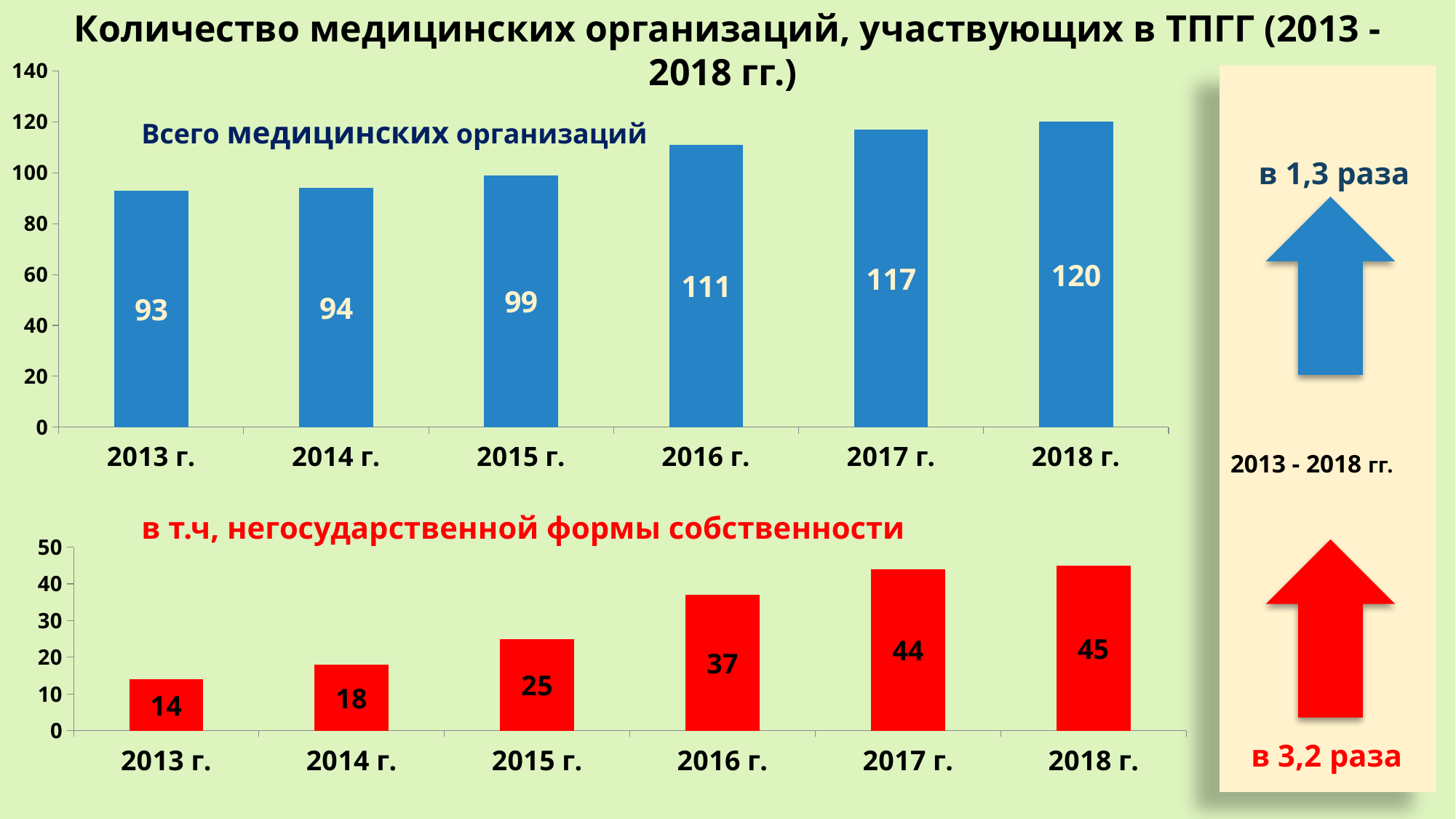
How many years are shown in the top chart (Всего медицинских организаций)? 6 In the bottom chart (в т.ч, негосударственной формы собственности), is the value for 2017 г. greater or less than 40? greater What kind of chart is the bottom chart (в т.ч, негосударственной формы собственности)? bar chart In the bottom chart (в т.ч, негосударственной формы собственности), which year has the lowest value? 2013 г. In the bottom chart (в т.ч, негосударственной формы собственности), do the values rise or fall from 2013 г. to 2018 г.? rise In the bottom chart (в т.ч, негосударственной формы собственности), what is the difference between the values for 2016 г. and 2014 г.? 19 In the top chart (Всего медицинских организаций), which year has the highest value? 2018 г. In the top chart (Всего медицинских организаций), which is larger: the value for 2015 г. or the value for 2017 г.? 2017 г. In the top chart (Всего медицинских организаций), what is the difference between the values for 2018 г. and 2013 г.? 27 What colour are the bars in the top chart (Всего медицинских организаций)? blue In the bottom chart (в т.ч, негосударственной формы собственности), what is the value for 2015 г.? 25 In the top chart (Всего медицинских организаций), what is the value for 2016 г.? 111